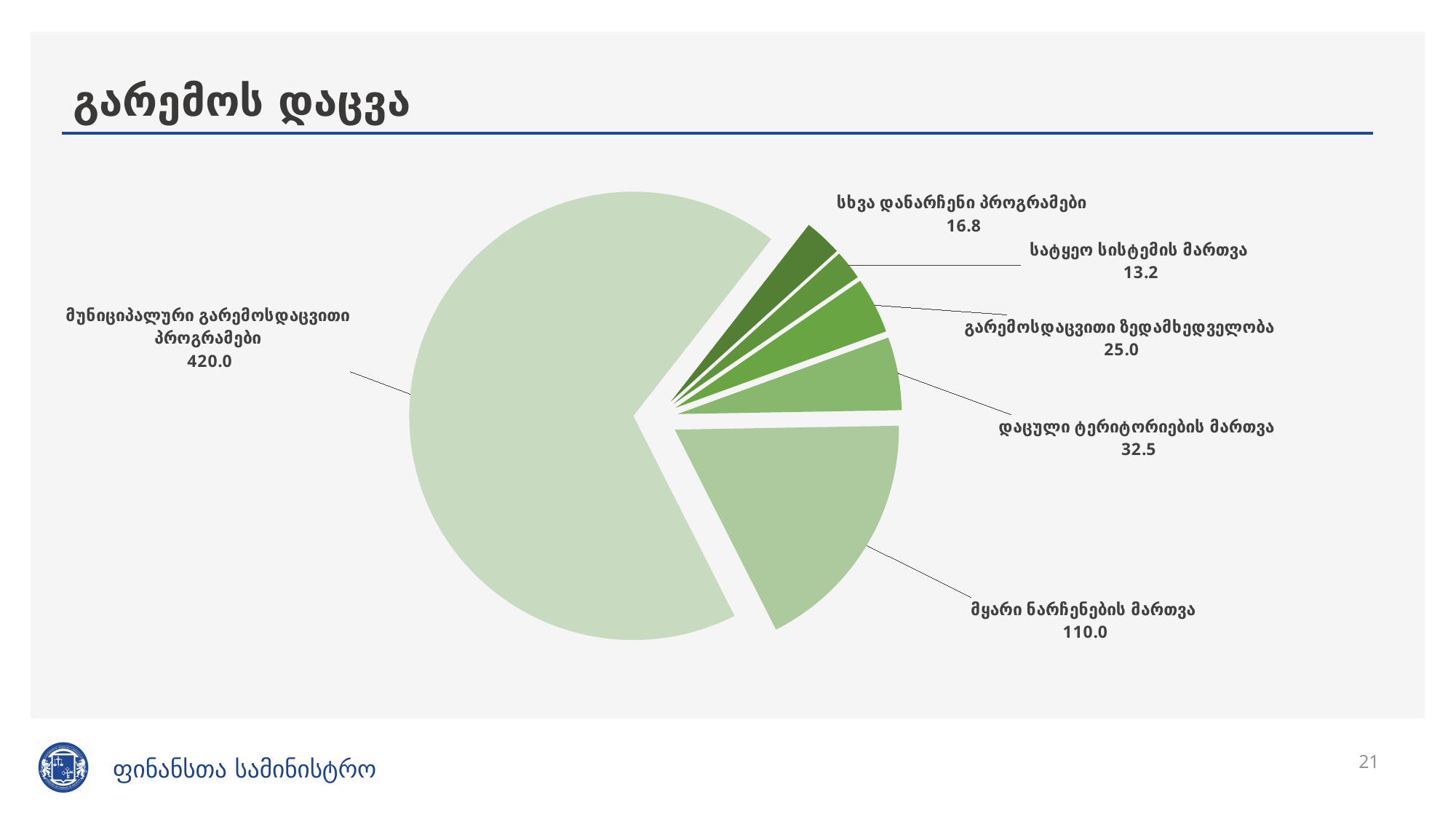
What is the difference between the values for მყარი ნარჩენების მართვა and დაცული ტერიტორიების მართვა? 77.5 What kind of chart is shown on the slide? pie chart What is the value for მყარი ნარჩენების მართვა? 110.0 How many slices does the pie chart have? 6 What is the value for სატყეო სისტემის მართვა? 13.2 Which category has the smallest slice of the pie? სატყეო სისტემის მართვა What is the value for დაცული ტერიტორიების მართვა? 32.5 Which category has the largest slice of the pie? მუნიციპალური გარემოსდაცვითი პროგრამები Which is larger, გარემოსდაცვითი ზედამხედველობა or სხვა დანარჩენი პროგრამები? გარემოსდაცვითი ზედამხედველობა What is the total of all the slices in the pie chart? 617.5 What is the title of the chart on the slide? გარემოს დაცვა What is the value for მუნიციპალური გარემოსდაცვითი პროგრამები? 420.0